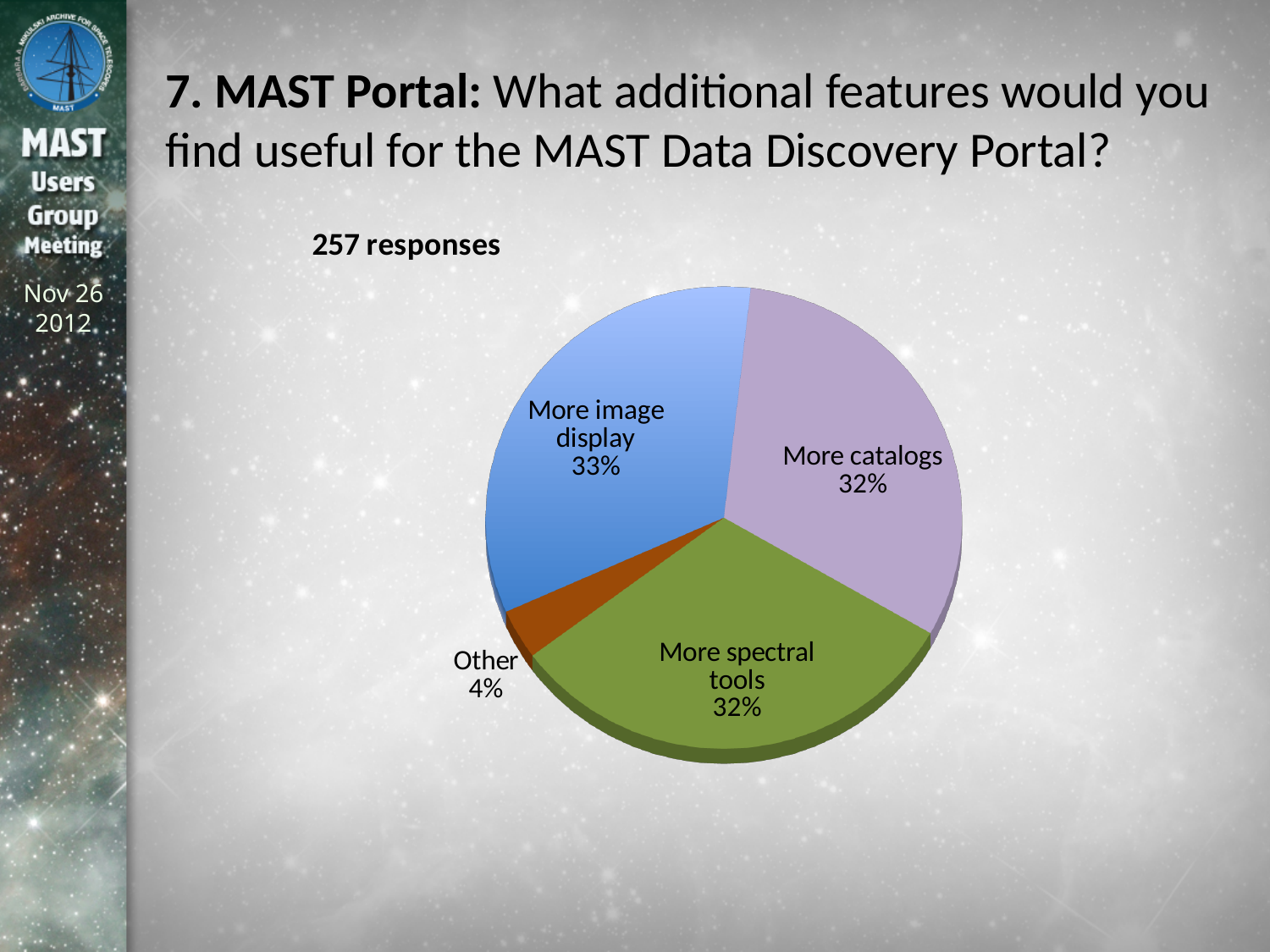
What share of responses is labelled "Other"? 4% How many responses does the slide say the chart is based on? 257 responses What share of responses is labelled "More spectral tools"? 32% What share of responses is labelled "More image display"? 33% How many slices does the pie chart have? 4 Which slice of the pie is the smallest? Other What share of responses is labelled "More catalogs"? 32% What colour is the "More spectral tools" slice? green What is the difference in percentage points between the "More image display" slice and the "Other" slice? 29 What kind of chart is shown on the slide? pie chart Which is larger, the "More catalogs" slice or the "Other" slice? More catalogs